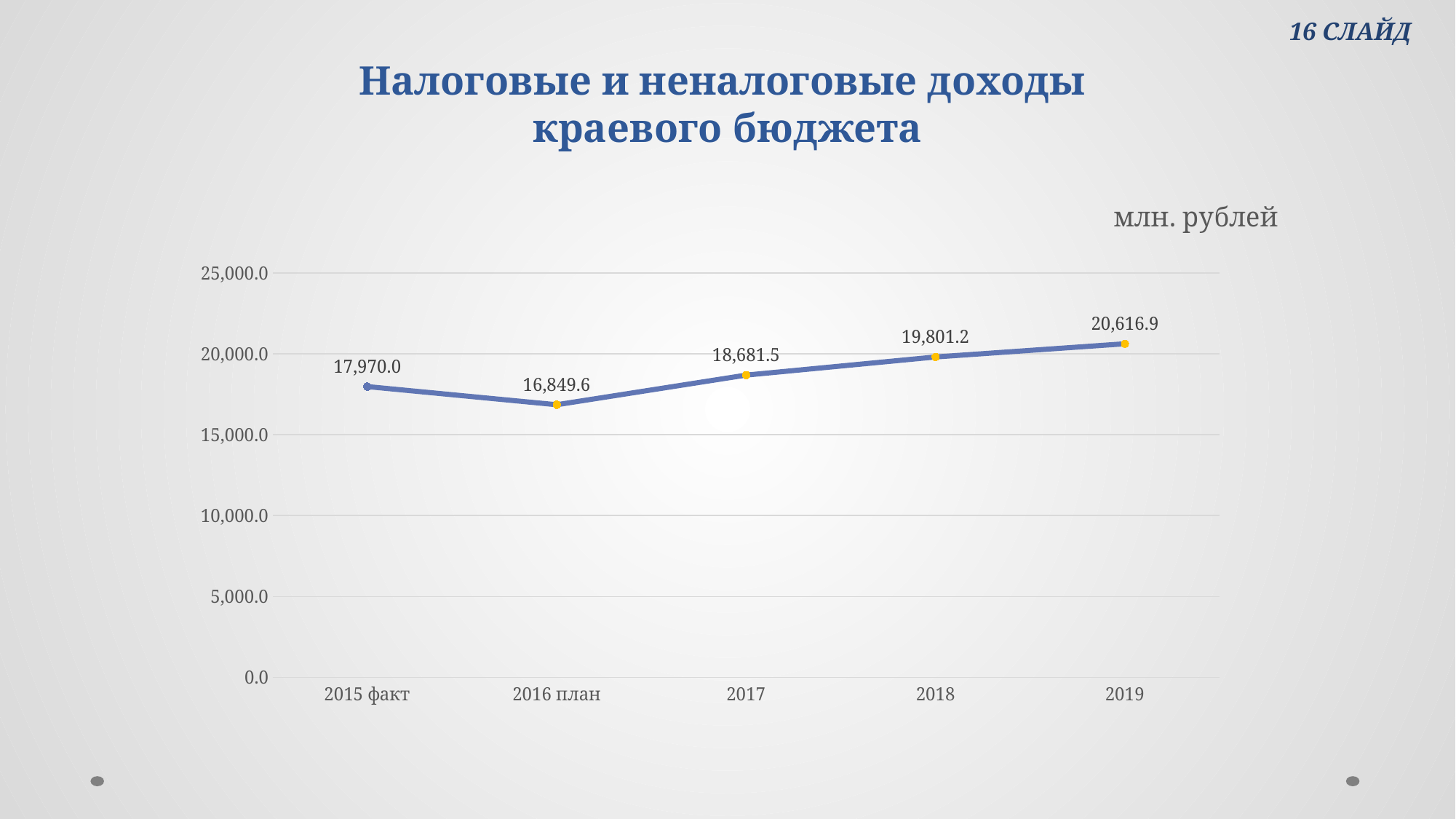
Which category has the lowest value? 2016 план Which is larger, the value for 2015 факт or the value for 2017? 2017 How many data points are plotted on the chart? 5 What is the value for 2016 план? 16,849.6 What is the value for 2018? 19,801.2 Which year has the highest value? 2019 What is the value for 2015 факт? 17,970.0 In what units are the values on the chart expressed? млн. рублей What is the difference between the values for 2017 and 2016 план? 1,831.9 What is the value for 2019? 20,616.9 What kind of chart is shown on the slide? line chart What is the difference between the values for 2019 and 2015 факт? 2,646.9